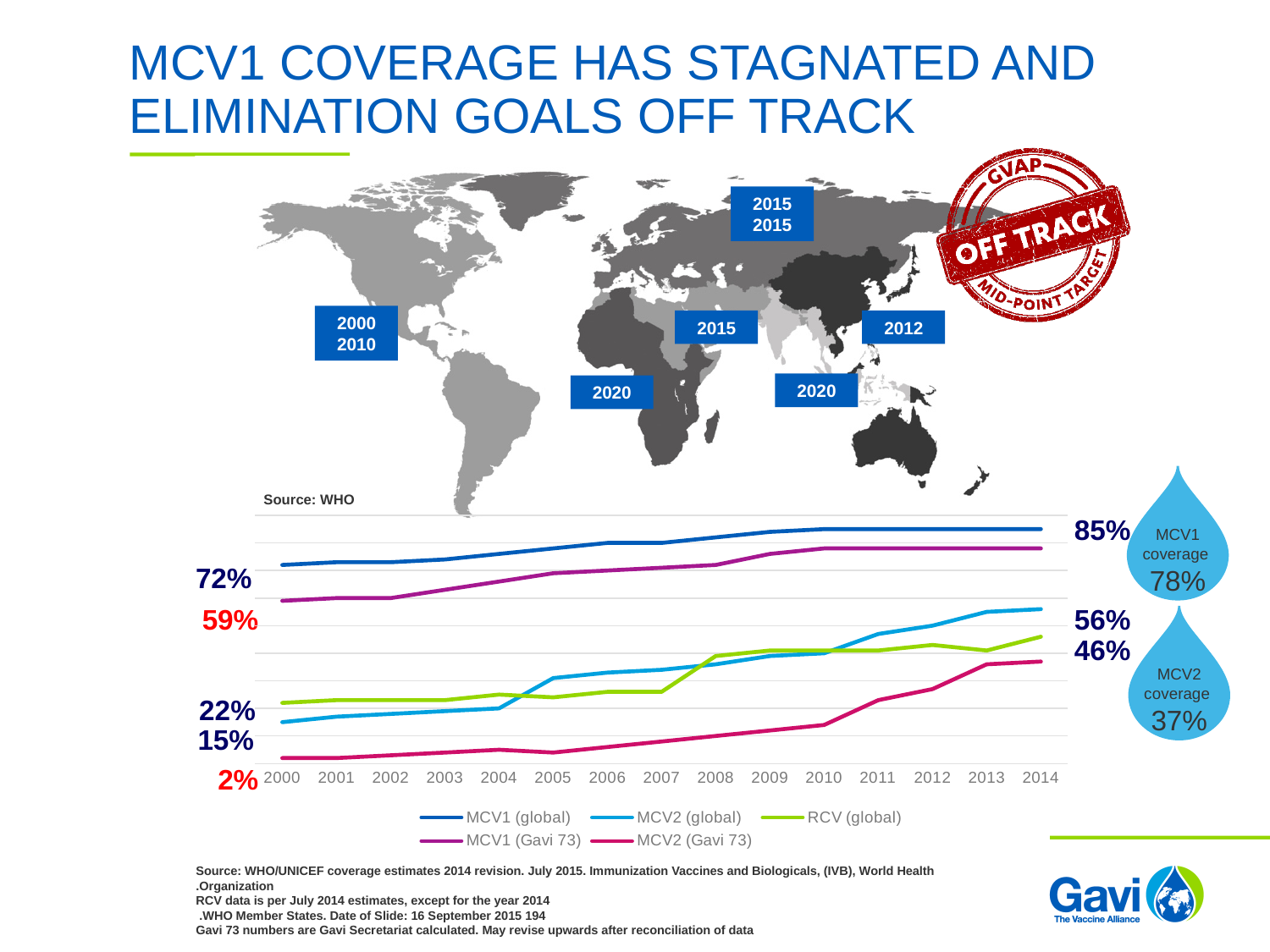
What type of chart is shown on the slide? Line chart Which series has the highest value in 2014? MCV1 (global) What is the MCV1 (Gavi 73) coverage value labelled for 2000? 59% How many series does the chart legend list? 5 How many years are shown along the x axis of the chart? 15 What is the MCV1 (global) coverage value labelled for 2014? 85% By how many percentage points did MCV1 (global) coverage change between 2000 and 2014? 13 percentage points What is the MCV2 (global) coverage value labelled for 2000? 15% What is the MCV2 (global) coverage value labelled for 2014? 56% Which series has the lowest value in 2000? MCV2 (Gavi 73) What is the MCV1 (global) coverage value labelled for 2000? 72% What is the MCV2 (Gavi 73) coverage value labelled for 2000? 2%